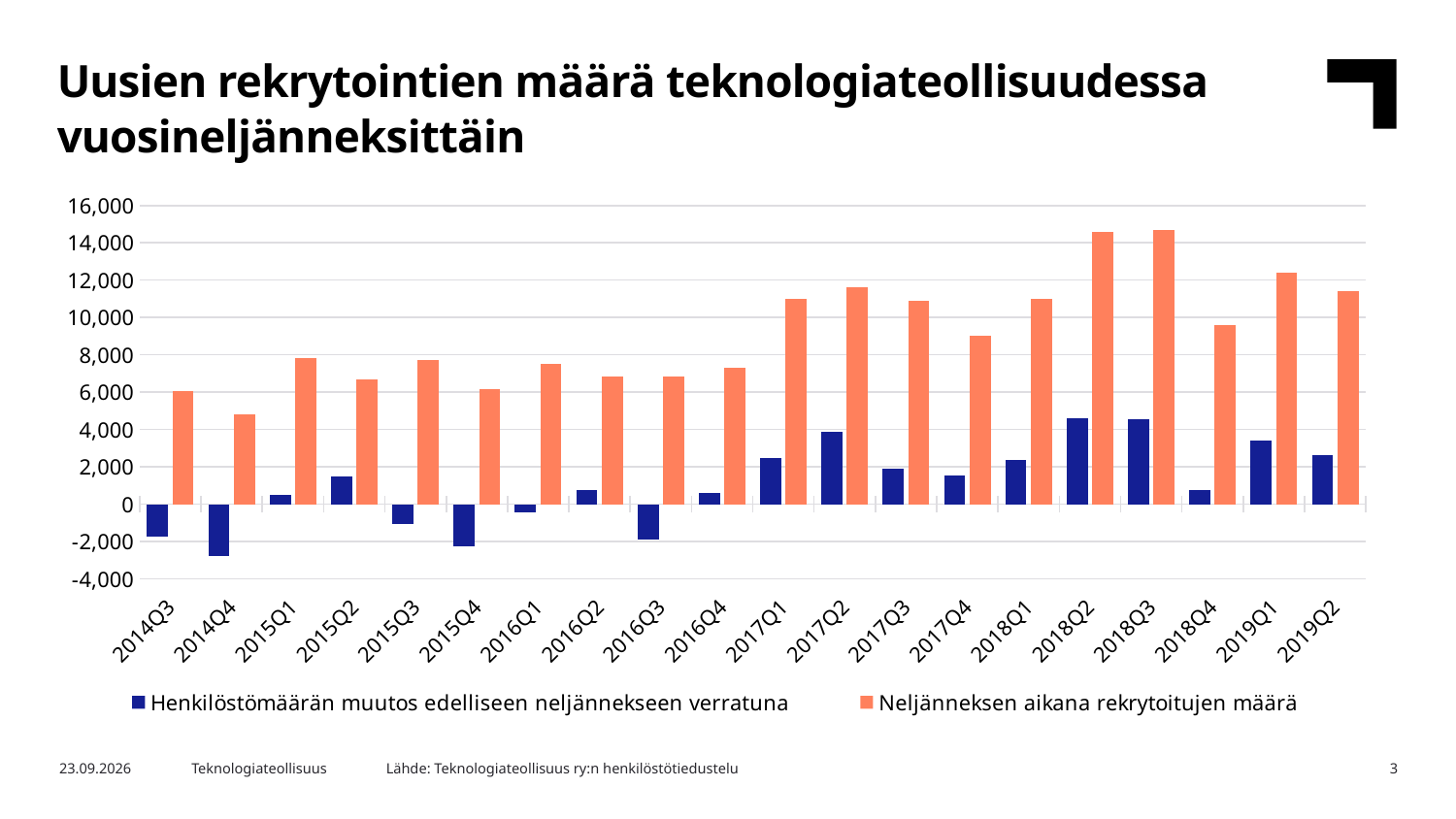
Is the value for 'Henkilöstömäärän muutos edelliseen neljännekseen verrattuna' in 2016Q3 greater or less than 0? less Which quarter has the lowest value for 'Neljänneksen aikana rekrytoitujen määrä'? 2014Q4 How many series does the legend list? 2 Is the value for 'Neljänneksen aikana rekrytoitujen määrä' in 2014Q4 greater or less than 6,000? less What kind of chart is shown on the slide? Bar chart Which is larger for 'Neljänneksen aikana rekrytoitujen määrä': 2017Q2 or 2017Q3? 2017Q2 Is the value for 'Neljänneksen aikana rekrytoitujen määrä' in 2019Q1 greater or less than 12,000? greater Does the 'Neljänneksen aikana rekrytoitujen määrä' series generally rise or fall from 2014Q3 to 2019Q2? Rise What colour are the bars for 'Neljänneksen aikana rekrytoitujen määrä'? Orange How many quarters are shown on the x axis? 20